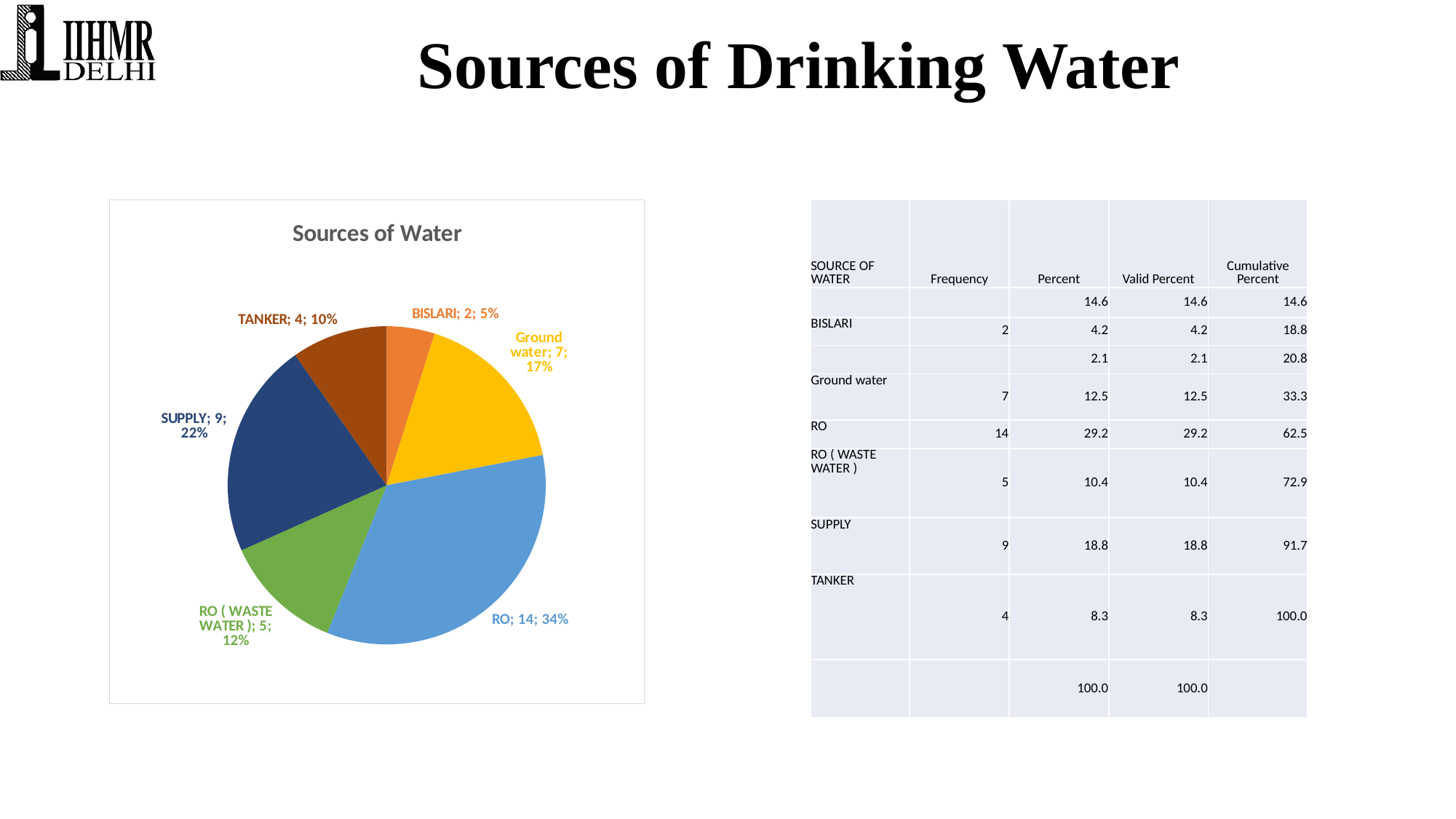
What share of the pie does RO ( WASTE WATER ) represent? 12% What kind of chart is shown on the slide? pie chart Which source has the smallest slice of the pie chart? BISLARI Which source has the largest slice of the pie chart? RO Which is larger, the value for Ground water or the value for TANKER? Ground water What is the value for SUPPLY in the pie chart? 9 What is the value for RO in the pie chart? 14 How many slices does the pie chart have? 6 What is the difference between the values for RO and SUPPLY? 5 What is the title of the chart? Sources of Water What is the value for TANKER in the pie chart? 4 What share of the pie does Ground water represent? 17%